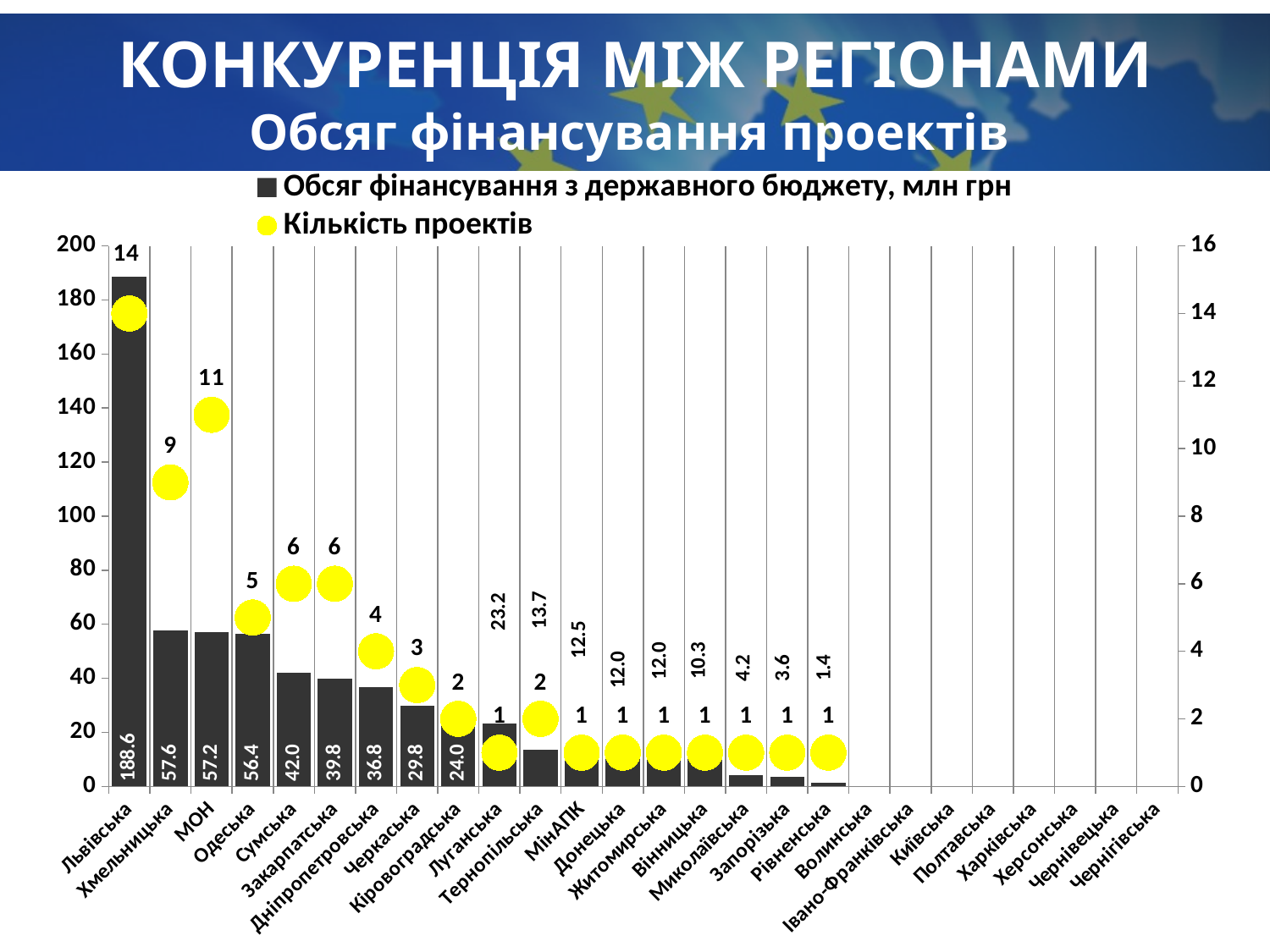
Which category has the second-highest number of projects? МОН Which has more projects, Одеська or Сумська? Сумська What is the funding value for Рівненська? 1.4 Do the funding bars rise or fall from left to right along the x axis? fall How many series does the legend list? 2 What colour are the markers for the number of projects series? yellow What is the difference in funding between Львівська and Хмельницька? 131.0 What is the funding from the state budget for Львівська? 188.6 What is the funding value for Тернопільська? 13.7 How many projects does Хмельницька have? 9 How many categories are shown on the x axis? 26 Which region has the highest funding from the state budget? Львівська